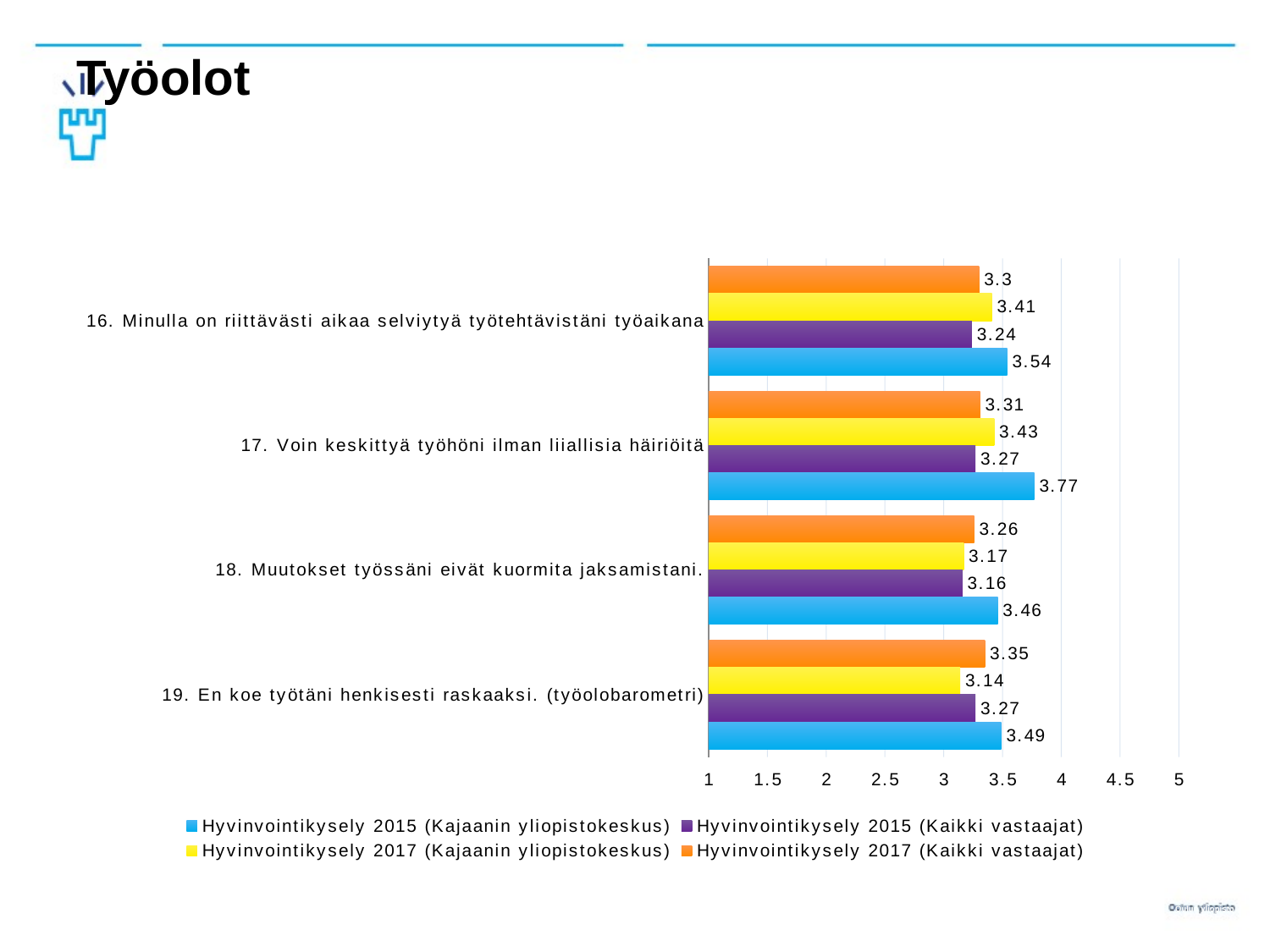
For which statement is the Hyvinvointikysely 2017 (Kajaanin yliopistokeskus) value lowest? 19. En koe työtäni henkisesti raskaaksi. (työolobarometri) How many categories (statements) are plotted on the chart? 4 For statement 19, which is larger: the Hyvinvointikysely 2017 (Kaikki vastaajat) value or the Hyvinvointikysely 2017 (Kajaanin yliopistokeskus) value? Hyvinvointikysely 2017 (Kaikki vastaajat) How many series does the legend list? 4 What is the value for Hyvinvointikysely 2015 (Kajaanin yliopistokeskus) for statement 17 (Voin keskittyä työhöni ilman liiallisia häiriöitä)? 3.77 What is the difference between the Hyvinvointikysely 2015 (Kajaanin yliopistokeskus) and Hyvinvointikysely 2015 (Kaikki vastaajat) values for statement 17? 0.5 For which statement is the Hyvinvointikysely 2015 (Kajaanin yliopistokeskus) value highest? 17. Voin keskittyä työhöni ilman liiallisia häiriöitä What kind of chart is shown on the slide? Bar chart Which colour represents Hyvinvointikysely 2017 (Kajaanin yliopistokeskus) in the legend? Yellow What is the value for Hyvinvointikysely 2017 (Kaikki vastaajat) for statement 19 (En koe työtäni henkisesti raskaaksi)? 3.35 What is the value for Hyvinvointikysely 2017 (Kajaanin yliopistokeskus) for statement 16 (Minulla on riittävästi aikaa selviytyä työtehtävistäni työaikana)? 3.41 What is the value for Hyvinvointikysely 2015 (Kaikki vastaajat) for statement 18 (Muutokset työssäni eivät kuormita jaksamistani)? 3.16